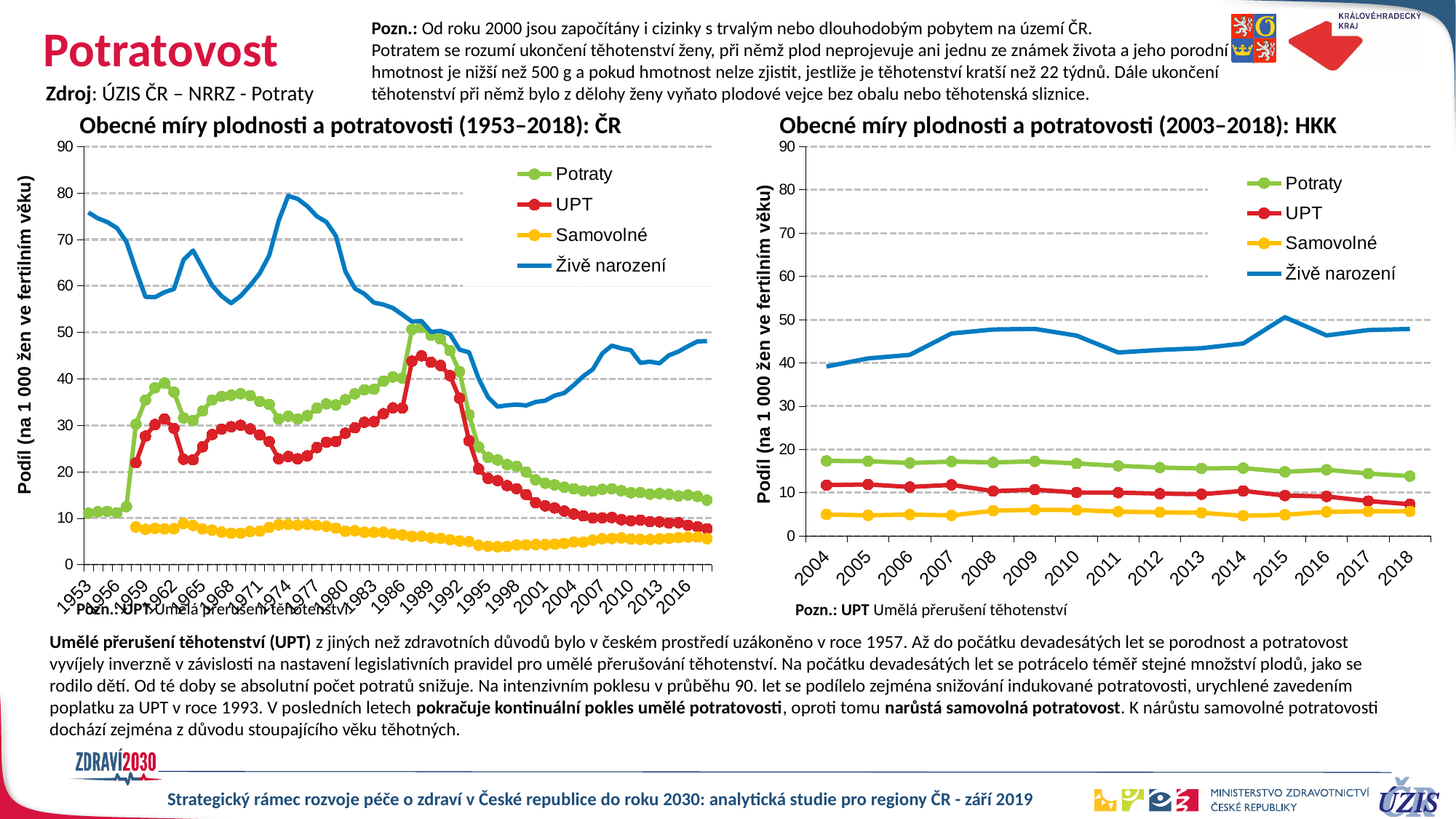
What kind of chart is the left chart titled 'Obecné míry plodnosti a potratovosti (1953–2018): ČR'? line chart In the left chart (ČR), which series has the highest value in 1953? Živě narození In the left chart (ČR), is the value for Potraty in 1988 greater or less than 40? greater What is the y-axis title of the left chart (ČR)? Podíl (na 1 000 žen ve fertilním věku) In the right chart (HKK), does the UPT series rise or fall from 2004 to 2018? fall In the right chart (HKK), how many years are shown on the x axis? 15 In the right chart (HKK), what colour is the Samovolné line? yellow In the left chart (ČR), is the value for Živě narození in 1974 greater or less than 70? greater How many series does the legend of the right chart (2003–2018: HKK) list? 4 In the right chart (HKK), is the value for Potraty in 2004 greater or less than 15? greater In the right chart (HKK), which is larger in 2018: Potraty or UPT? Potraty